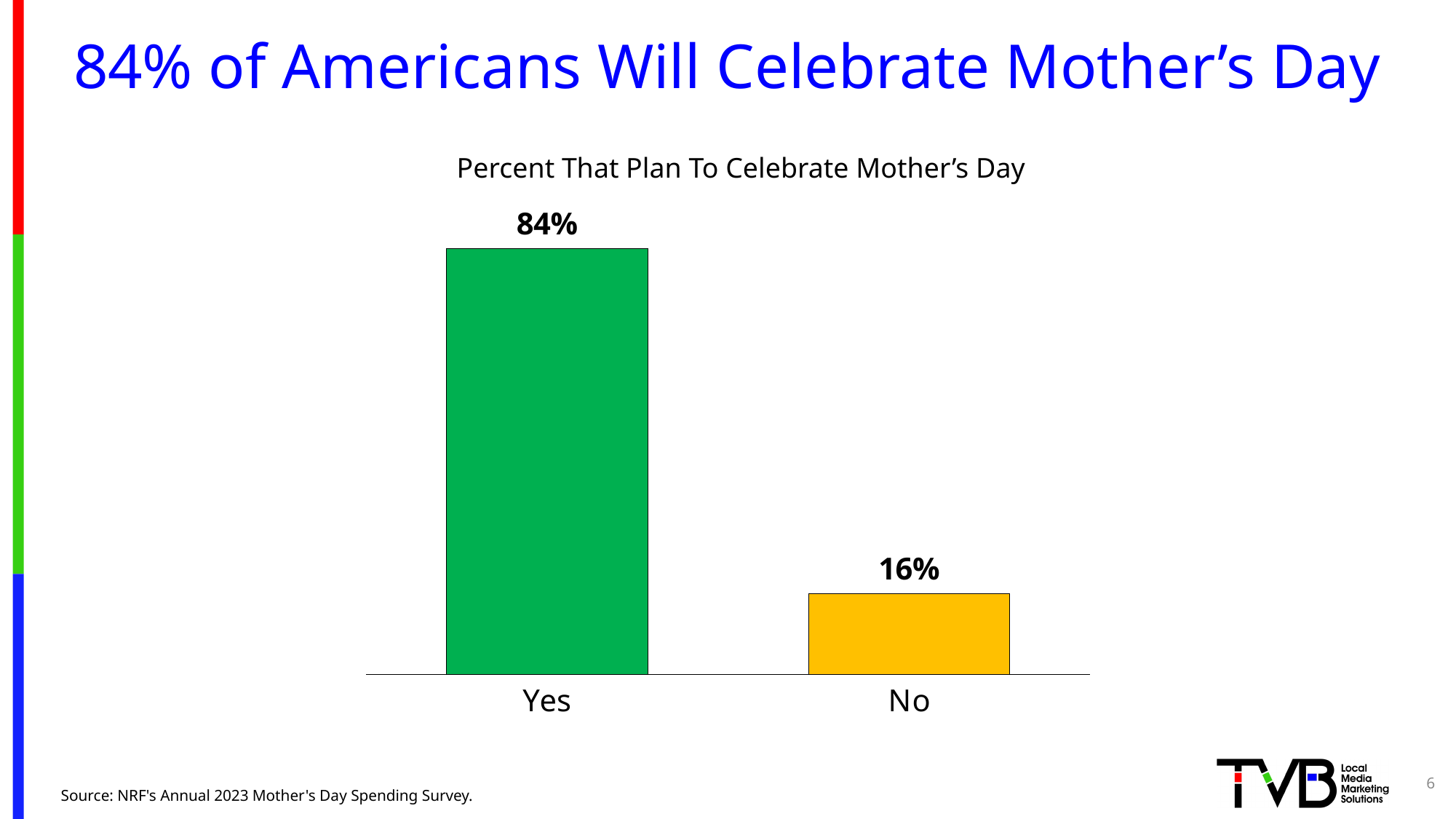
How many categories are shown in the chart? 2 What is the difference in percentage points between the Yes and No bars? 68 Which category has the highest value in the chart? Yes Which category has the lowest value in the chart? No What is the title of the chart? Percent That Plan To Celebrate Mother's Day Which is larger, the value for Yes or the value for No? Yes What kind of chart is shown on the slide? Bar chart What is the total of the Yes and No values? 100% What percent of respondents answered Yes to planning to celebrate Mother's Day? 84% What percent of respondents answered No to planning to celebrate Mother's Day? 16% What colour is the bar for the No category? Yellow